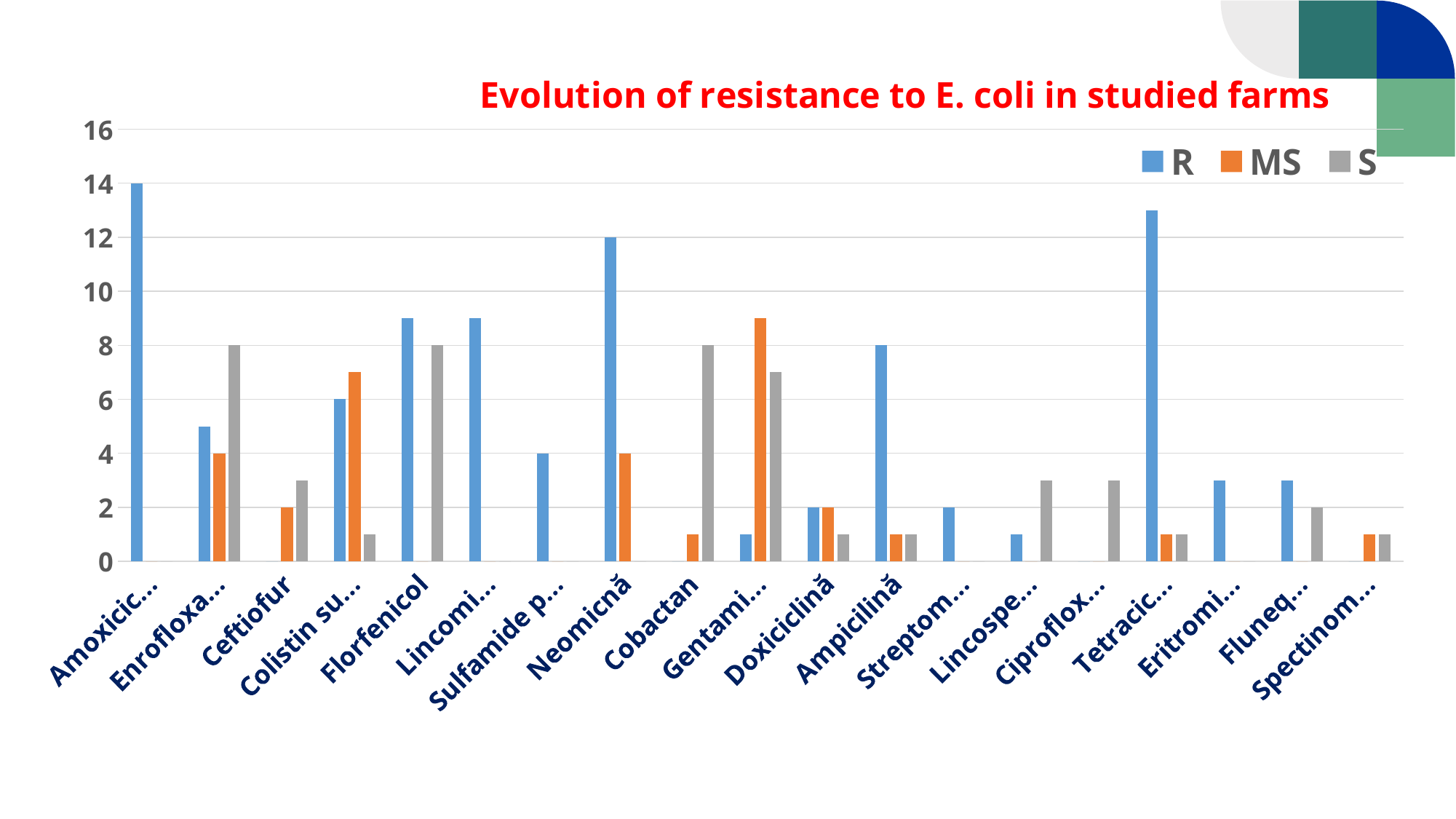
What is the S value for Florfenicol? 8 What is the difference between the R and MS values for Neomicnă? 8 How many categories are shown on the x axis? 19 Is the R value for Florfenicol greater or less than 8? greater What is the MS value for Ceftiofur? 2 What is the R value for Neomicnă? 12 What is the R value for Ampicilină? 8 How many series does the legend list? 3 What type of chart is shown on the slide? Bar chart What is the title of the chart? Evolution of resistance to E. coli in studied farms Which series has the highest value for Neomicnă? R For Cobactan, which is larger, the S value or the MS value? S